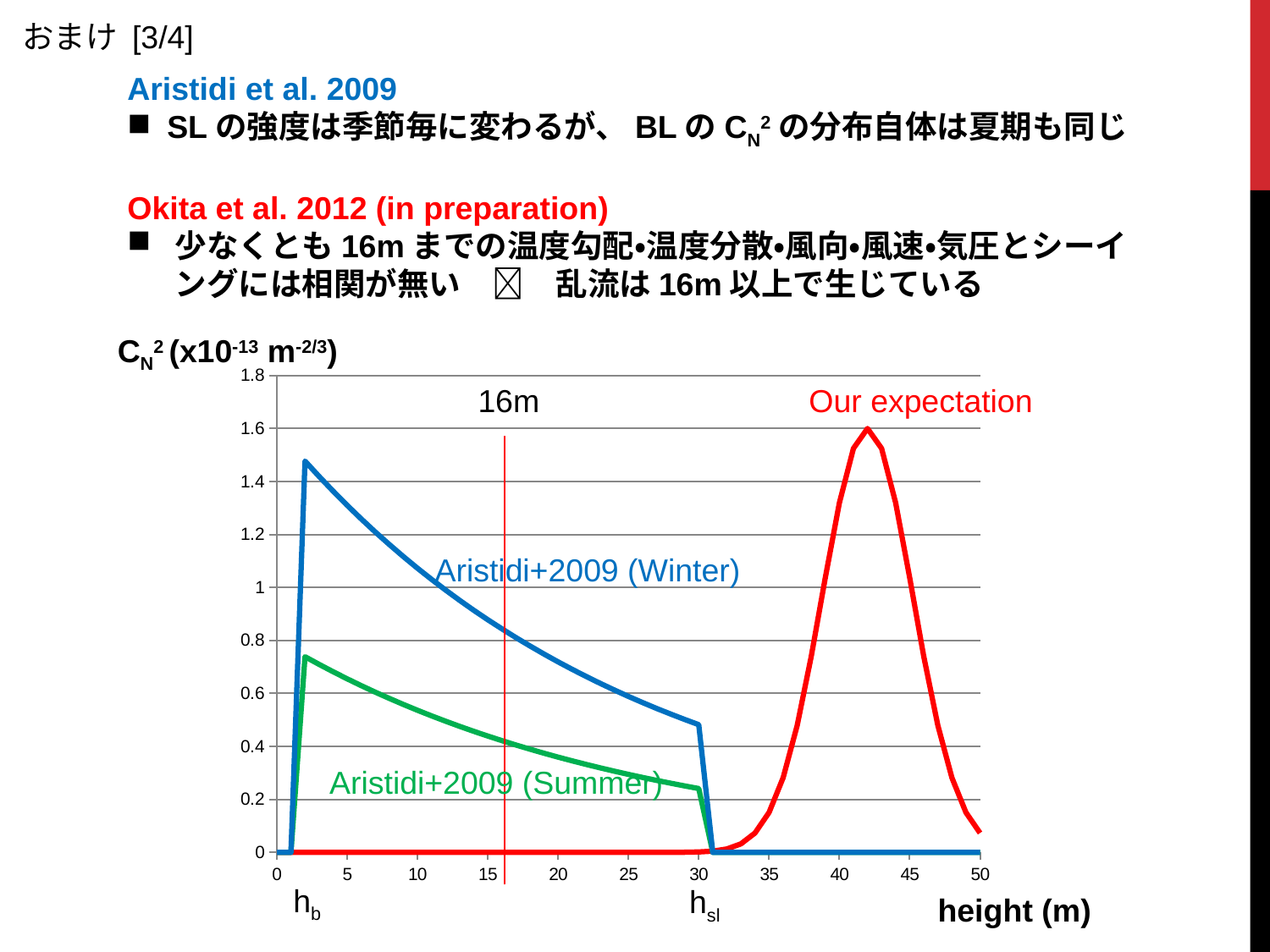
Which curve has the higher peak, Aristidi+2009 (Winter) or Aristidi+2009 (Summer)? Aristidi+2009 (Winter) Which of the three curves reaches the highest value on the chart? Our expectation How many curves (series) are labelled on the chart? 3 Is the peak value of the Aristidi+2009 (Summer) curve greater or less than 0.8? less Which of the three curves has the lowest peak value? Aristidi+2009 (Summer) Between heights of about 2 m and 30 m, does the Aristidi+2009 (Winter) curve rise or fall as height increases? fall Is the peak value of the 'Our expectation' curve greater or less than 1.2? greater What kind of chart is shown on the slide? line chart Is the peak value of the Aristidi+2009 (Winter) curve greater or less than 1.4? greater At what height is the vertical red reference line drawn on the chart? 16m What is the label of the x axis of the chart? height (m)